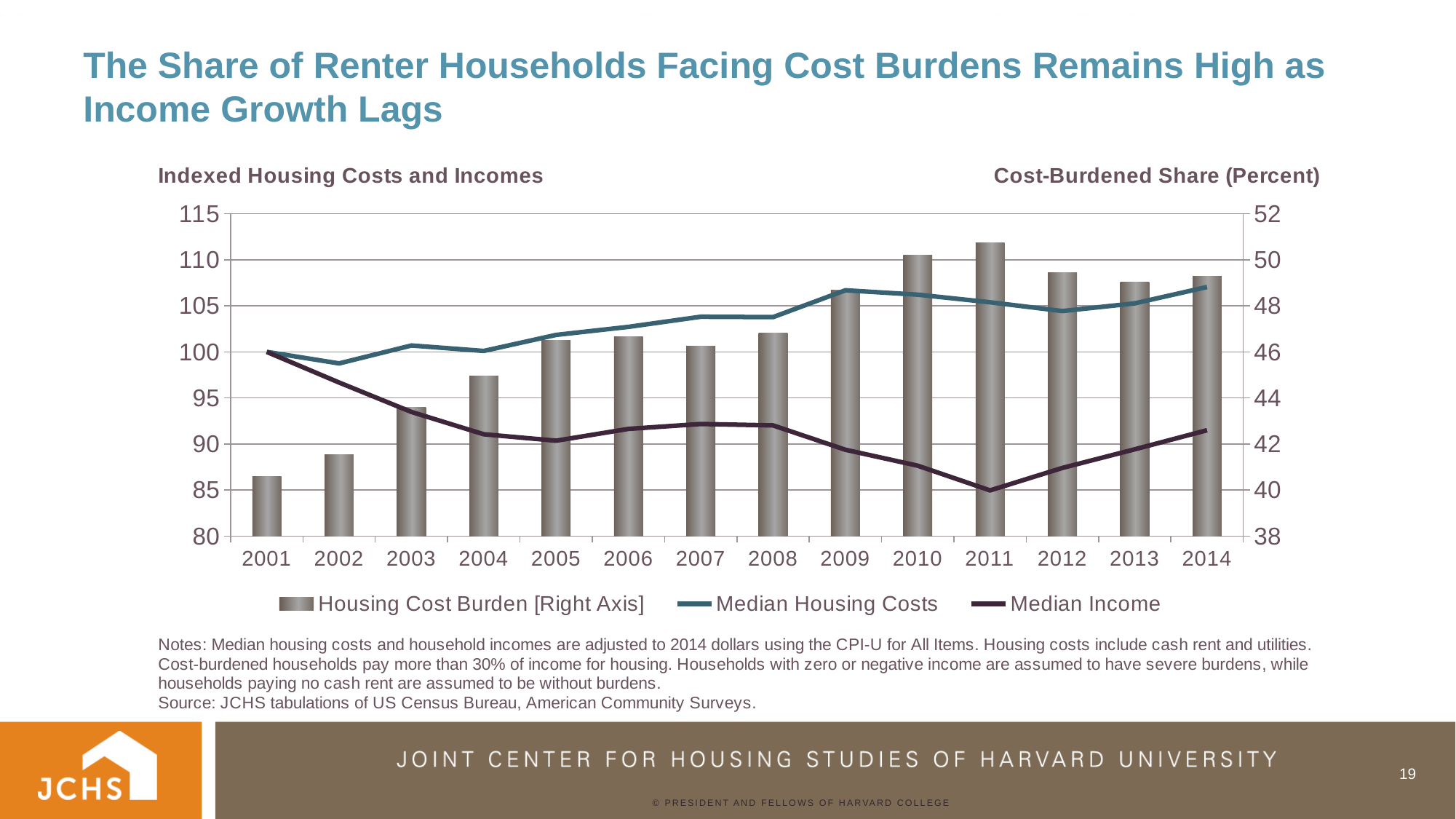
How many years are shown on the x axis? 14 Which series is plotted on the right axis according to the legend? Housing Cost Burden What kind of chart is shown on the slide? A combination bar and line chart In which year is the Housing Cost Burden bar highest? 2011 Is the Housing Cost Burden value for 2001 greater or less than 42? less How many series does the legend list? 3 Is the Housing Cost Burden value for 2011 greater or less than 50? greater Is the Median Housing Costs value for 2014 greater or less than 105? greater Does the Median Income line rise or fall overall from 2001 to 2011? Fall In which year is the Housing Cost Burden bar lowest? 2001 Which is larger, the Housing Cost Burden bar for 2010 or for 2005? 2010